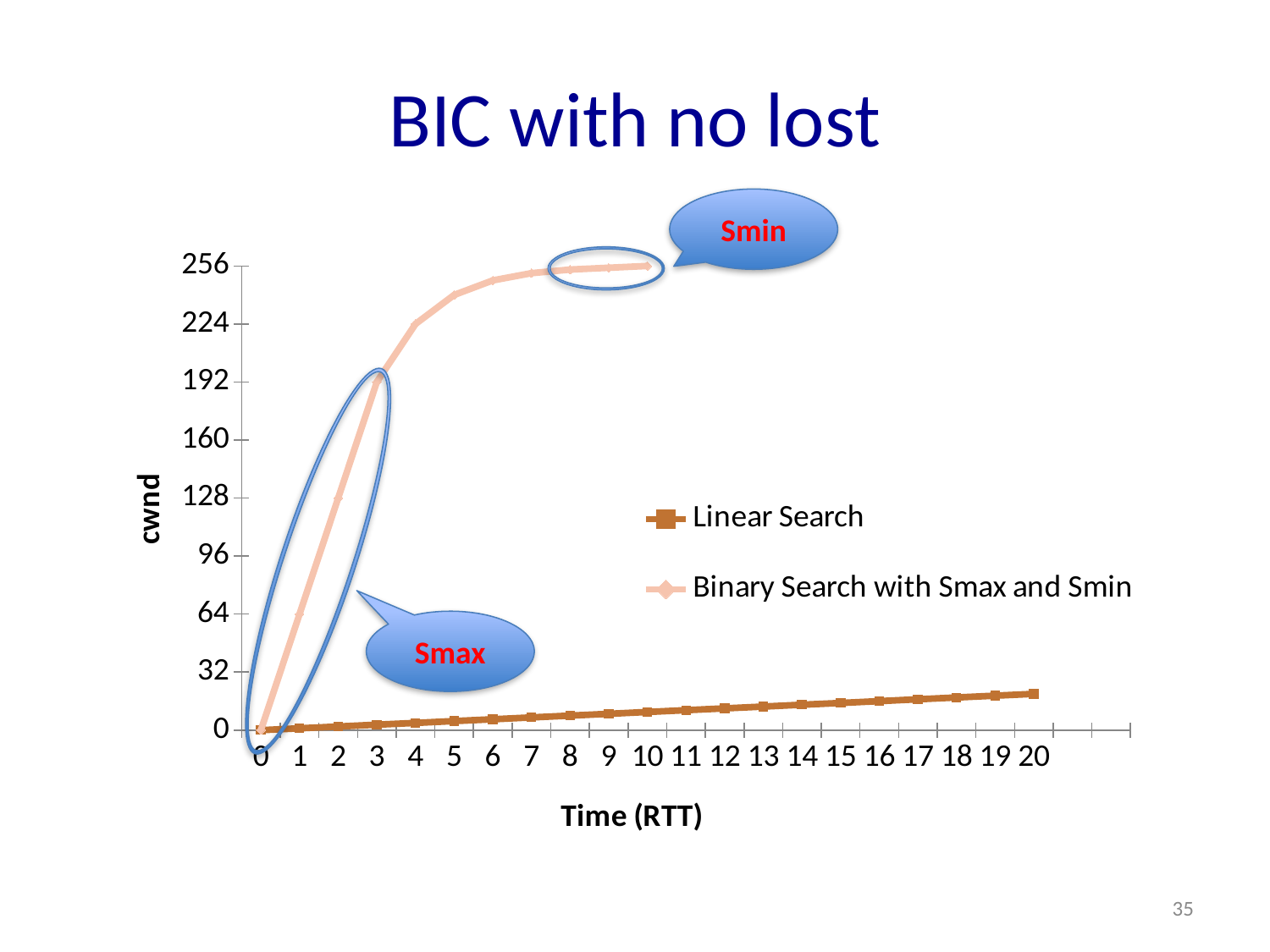
What kind of chart is shown on the slide? line chart What is the value of the Binary Search with Smax and Smin series at time 3? 192 At time 5, which series has the larger cwnd value, Linear Search or Binary Search with Smax and Smin? Binary Search with Smax and Smin How many series does the legend list? 2 Is the value for Binary Search with Smax and Smin at time 5 greater or less than 224? greater What is the title of the chart? BIC with no lost What is the value of the Binary Search with Smax and Smin series at time 2? 128 What is the label of the x axis? Time (RTT) Is the value for Linear Search at time 20 greater or less than 32? less Does the Linear Search series rise or fall as time increases? rise What is the highest cwnd value reached by the Binary Search with Smax and Smin series? 256 Which series reaches the higher cwnd value overall? Binary Search with Smax and Smin